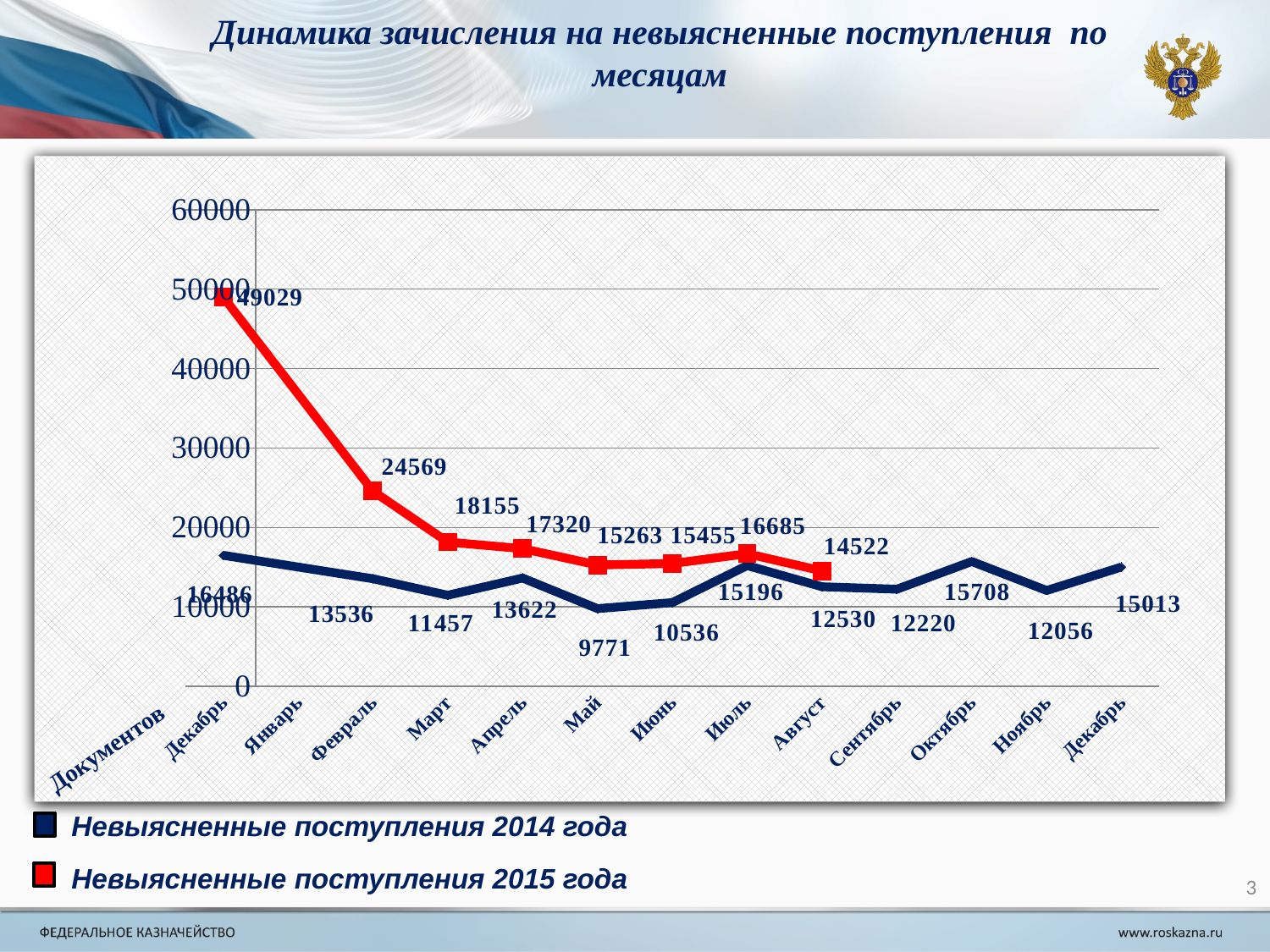
At the leftmost point (Декабрь), what is the difference between the 2015 value and the 2014 value? 32543 At the leftmost point (Декабрь), which series has the larger value, 2014 or 2015? 2015 What kind of chart is shown on the slide? line chart What is the highest value plotted for the 2015 series? 49029 What is the value of the 2015 series (Невыясненные поступления 2015 года) at the leftmost point, Декабрь? 49029 Does the 2015 series (red line) rise or fall overall from left to right? fall What is the value of the 2014 series at the rightmost point, Декабрь? 15013 How many series does the legend list? 2 What is the value of the 2014 series (Невыясненные поступления 2014 года) at the leftmost point, Декабрь? 16486 What is the lowest value plotted for the 2014 series? 9771 Which colour is used for the series Невыясненные поступления 2015 года? red What is the lowest value plotted for the 2015 series? 14522